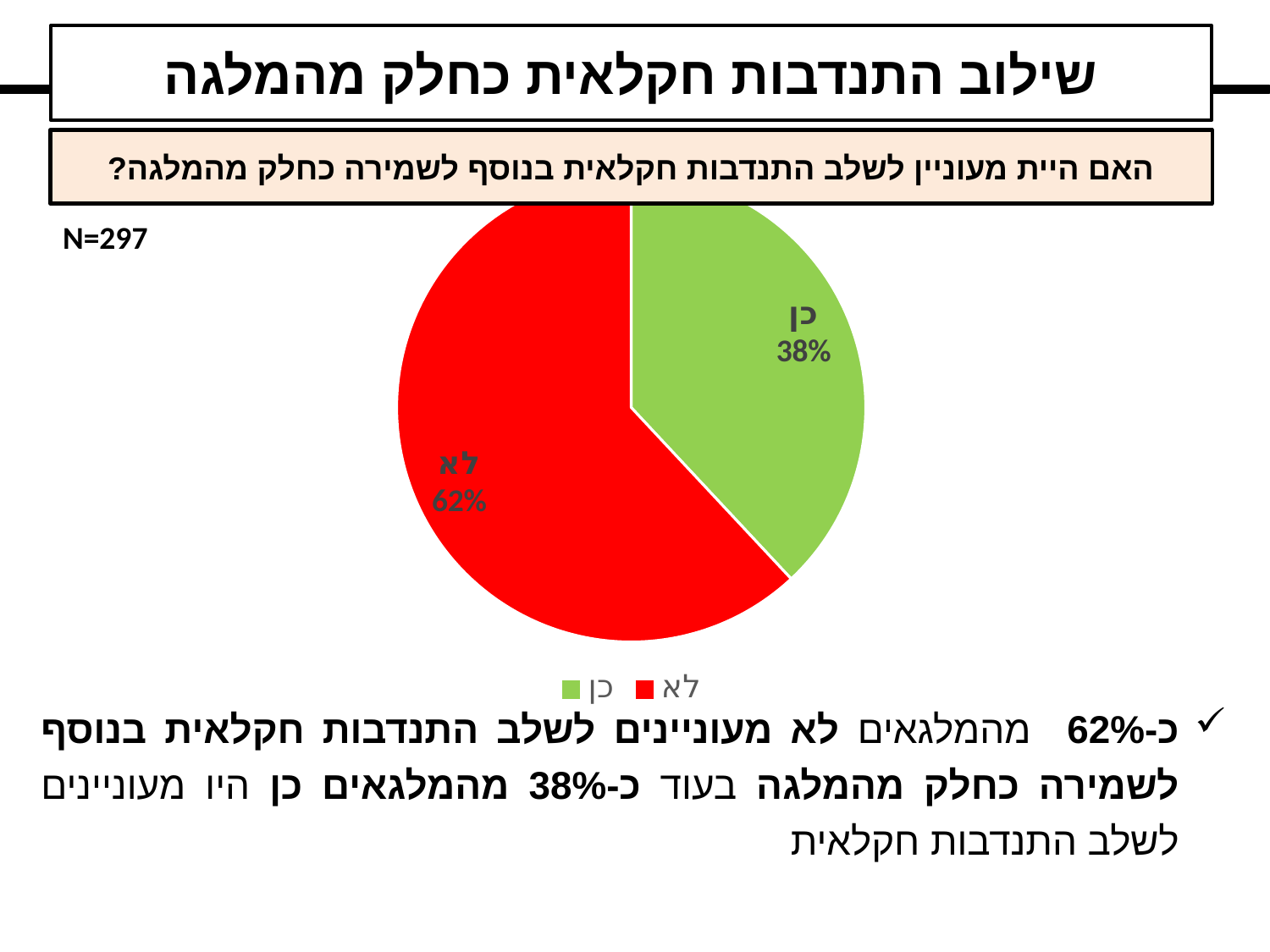
How many slices does the pie chart have? 2 How many entries does the legend list? 2 Which slice is the smallest in the pie chart? כן What percentage is shown for the "כן" (yes) slice? 38% What percentage is shown for the "לא" (no) slice? 62% What is the sample size (N) shown on the slide? N=297 Which is larger, the "כן" slice or the "לא" slice? לא What kind of chart is shown on the slide? pie chart Which slice is the largest in the pie chart? לא What colour is the "כן" slice? green What colour is the "לא" slice? red What is the difference in percentage points between the "לא" slice and the "כן" slice? 24